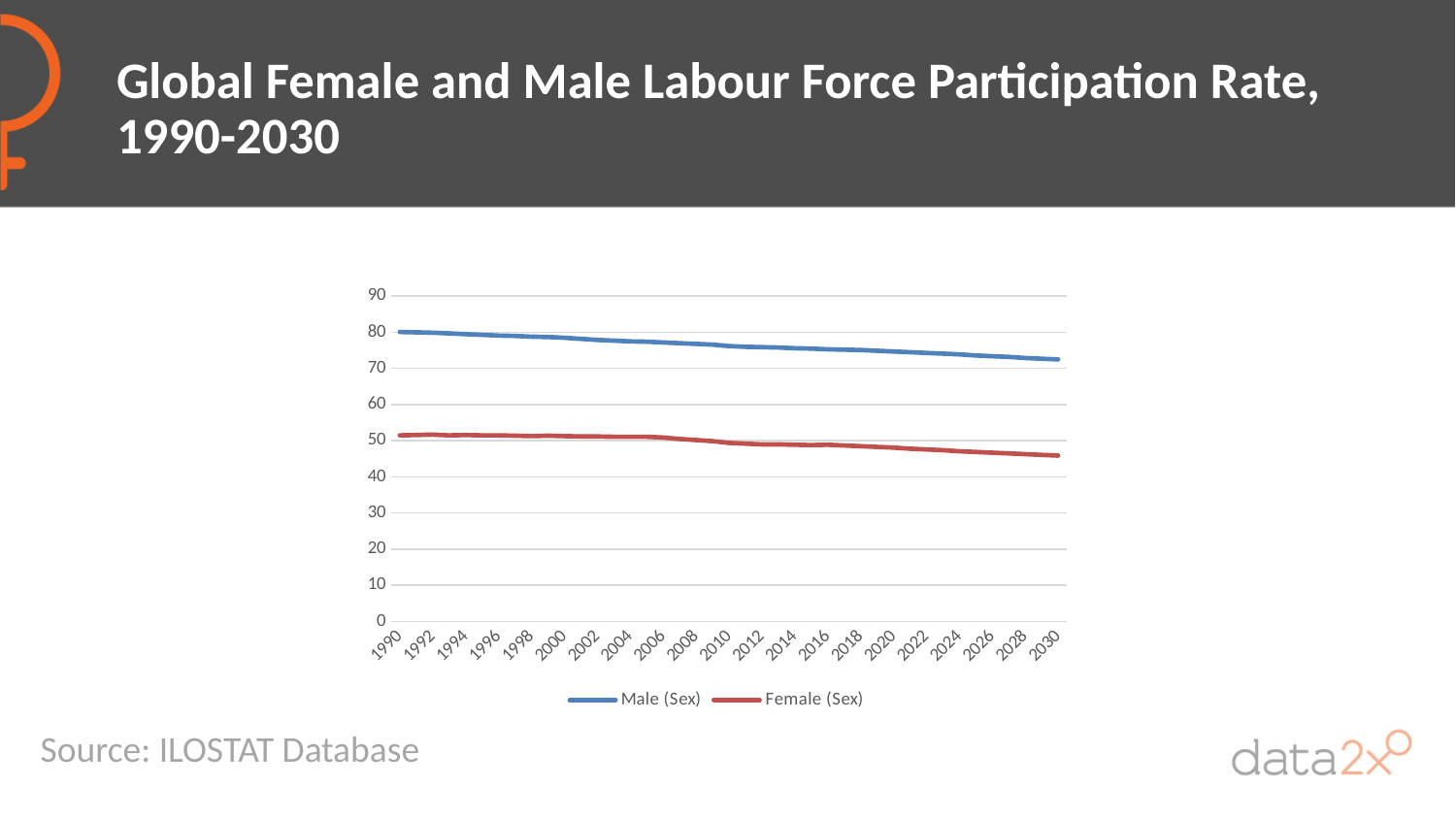
Is the value for Female (Sex) in 1990 greater or less than 60? less Does the Male (Sex) line rise or fall from 1990 to 2030? Fall Is the value for Male (Sex) in 2030 greater or less than 80? less Is the value for Male (Sex) in 1990 greater or less than 70? greater What are the two series named in the legend? Male (Sex) and Female (Sex) How many series does the legend list? 2 How many years are labelled along the x axis? 21 What colour is the Female (Sex) line? Red Does the Female (Sex) line rise or fall from 1990 to 2030? Fall What kind of chart is shown on the slide? Line chart Which series has the higher value in 2010, Male (Sex) or Female (Sex)? Male (Sex)